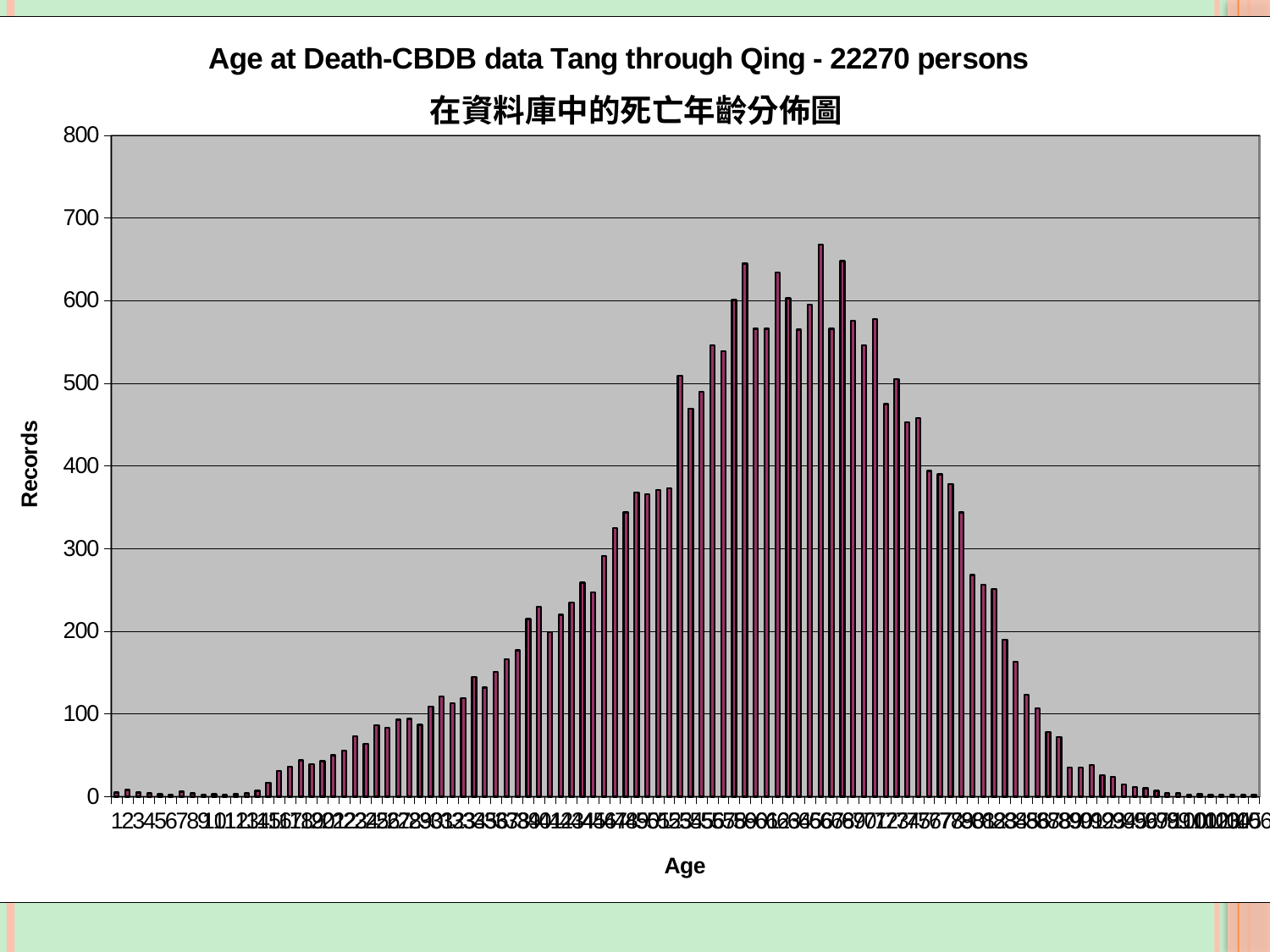
What is the label of the vertical axis? Records Is the value for age 1 greater or less than 100? less Do the values rise or fall along the x axis over the first ten ages shown? roughly flat, staying near 0 Is the tallest bar in the chart greater or less than 600? greater What is the highest tick value shown on the vertical axis? 800 Which is larger, the value for age 1 or the tallest bar near the middle of the age range? the tallest bar near the middle What is the title of the chart? Age at Death-CBDB data Tang through Qing - 22270 persons Is the tallest bar in the chart greater or less than 700? less What kind of chart is shown on the slide? bar chart